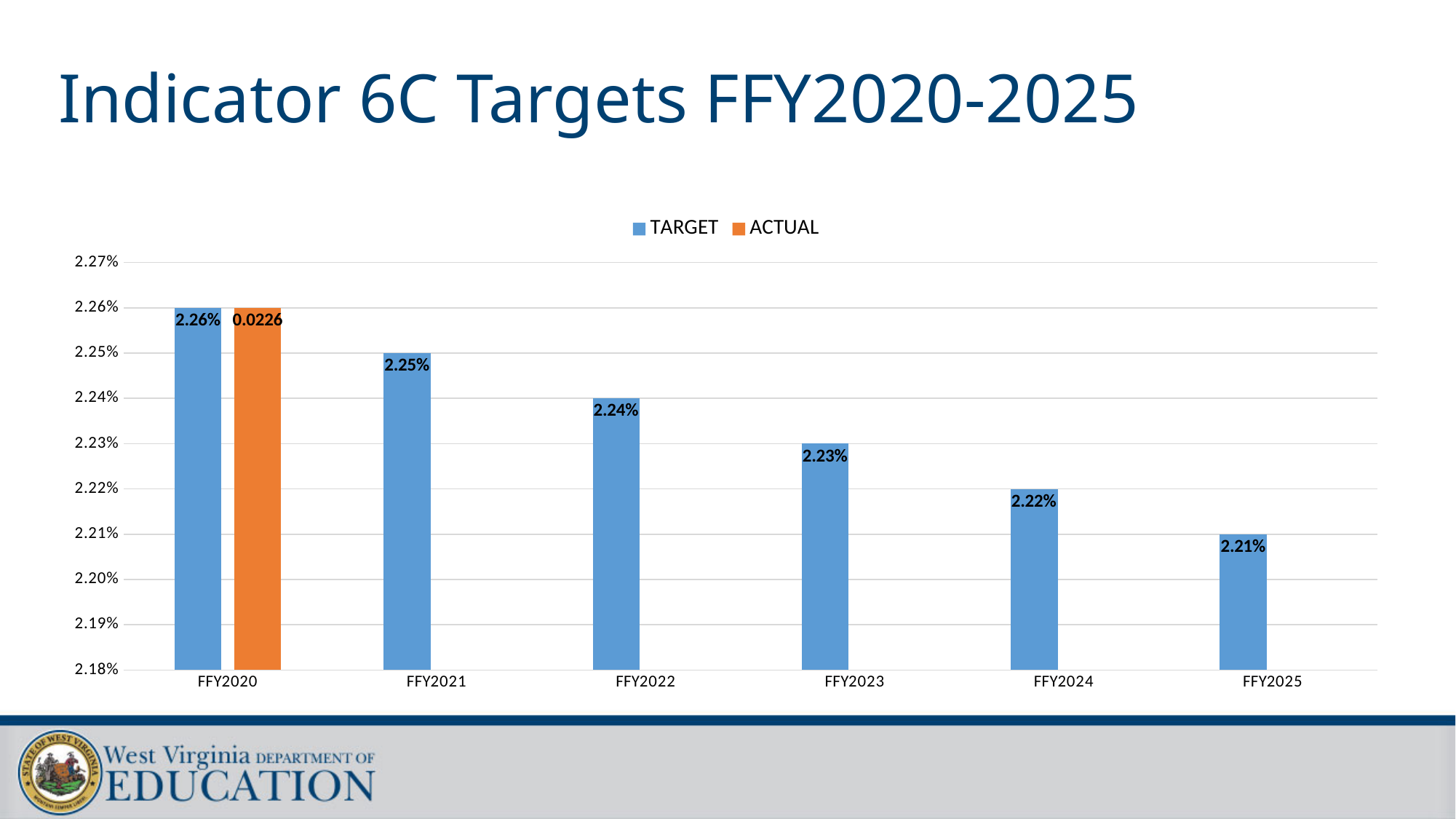
How many series does the legend list? 2 How many years are shown on the x axis? 6 What is the TARGET value for FFY2023? 2.23% What is the ACTUAL value shown for FFY2020? 0.0226 Which year has the highest TARGET value? FFY2020 What kind of chart is shown on the slide? Bar chart What is the TARGET value for FFY2021? 2.25% What is the difference between the TARGET values for FFY2020 and FFY2025? 0.05% What is the TARGET value for FFY2025? 2.21% Which year has the lowest TARGET value? FFY2025 Do the TARGET values rise or fall from FFY2020 to FFY2025? Fall Which is larger, the TARGET for FFY2022 or the TARGET for FFY2024? FFY2022